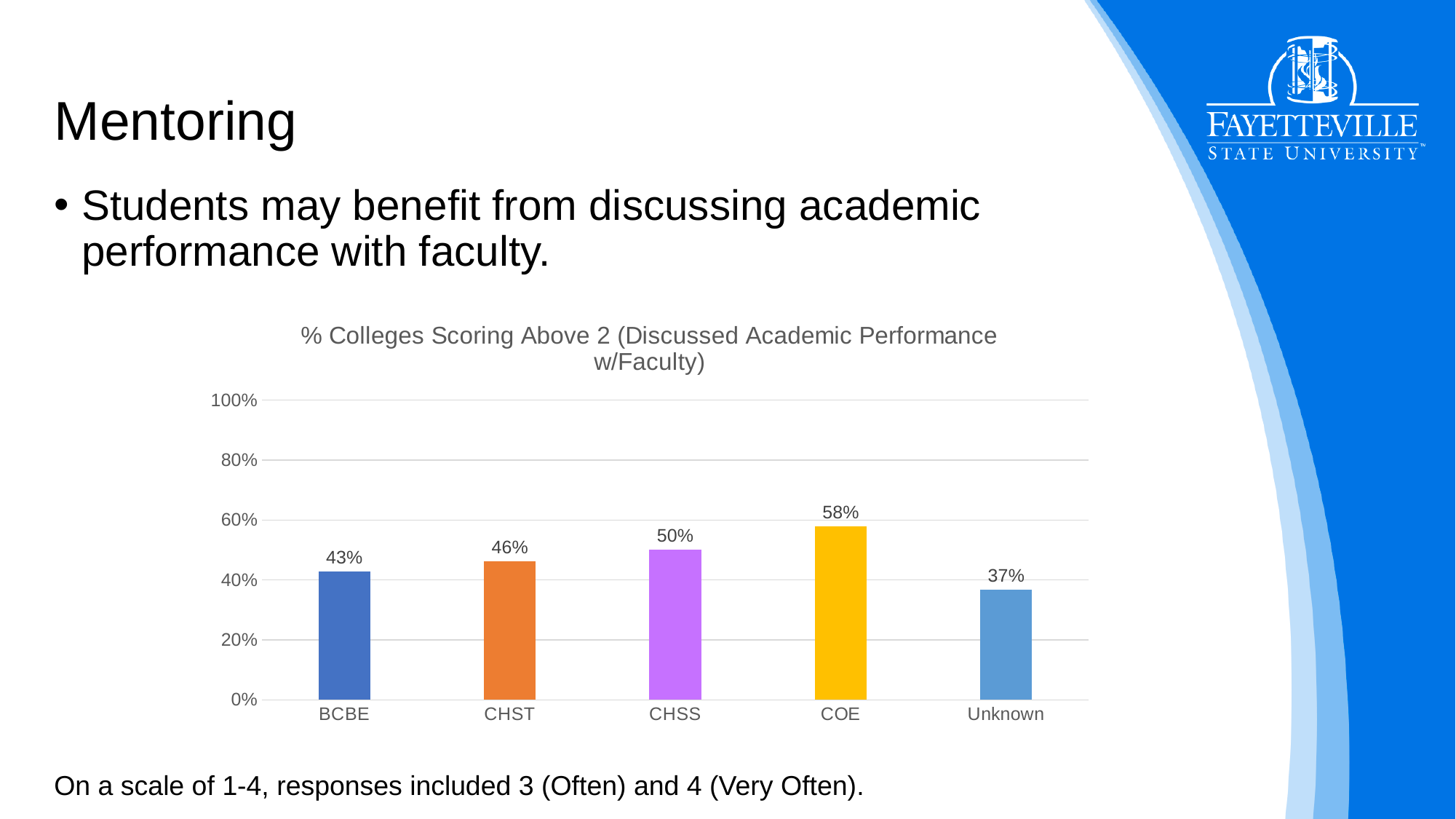
What is the difference between the values for COE and Unknown? 21% What is the value for BCBE? 43% What is the value for Unknown? 37% Is the value for CHST greater or less than 60%? less Which category has the highest value? COE Which category has the lowest value? Unknown What is the difference between the values for CHSS and CHST? 4% What kind of chart is shown on the slide? bar chart What is the title of the chart? % Colleges Scoring Above 2 (Discussed Academic Performance w/Faculty) What is the value for COE? 58% How many categories are shown on the x axis? 5 Which is larger, the value for CHSS or the value for BCBE? CHSS